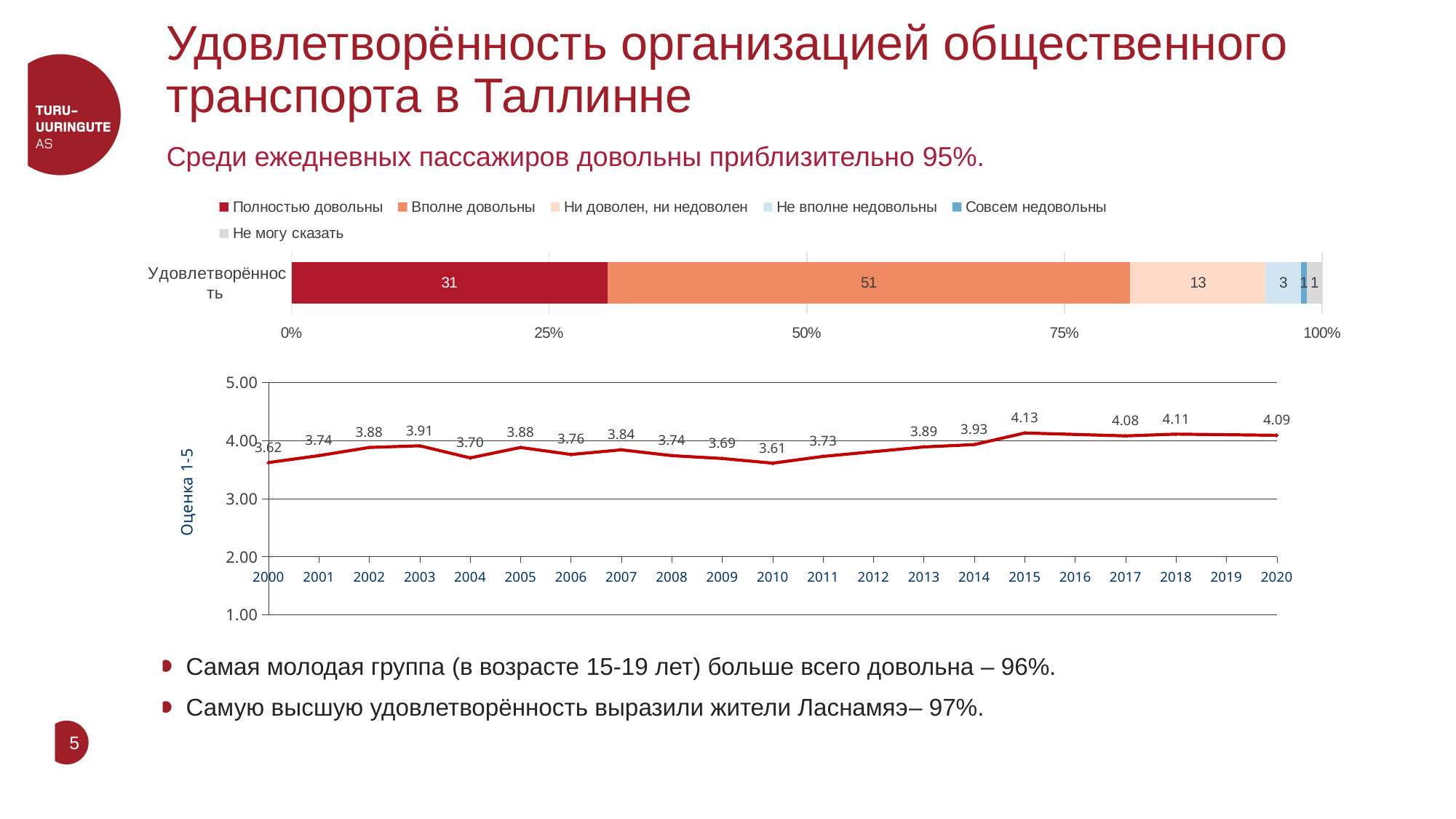
In the bottom line chart, which year has the lowest value? 2010 What kind of chart is the bottom chart? line chart In the bottom line chart, is the value for 2020 greater or less than 4.00? greater In the bottom line chart, what is the value for 2000? 3.62 In the bottom line chart, what is the value for 2015? 4.13 In the top stacked bar chart, which segment is the largest? Вполне довольны In the top stacked bar chart, what is the difference between 'Вполне довольны' and 'Полностью довольны'? 20 In the top stacked bar chart, what is the value for 'Ни доволен, ни недоволен'? 13 In the top stacked bar chart, what is the value for 'Вполне довольны'? 51 In the top stacked bar chart, how many series does the legend list? 6 In the bottom line chart, which year has the highest value? 2015 In the top stacked bar chart, what is the value for 'Полностью довольны'? 31